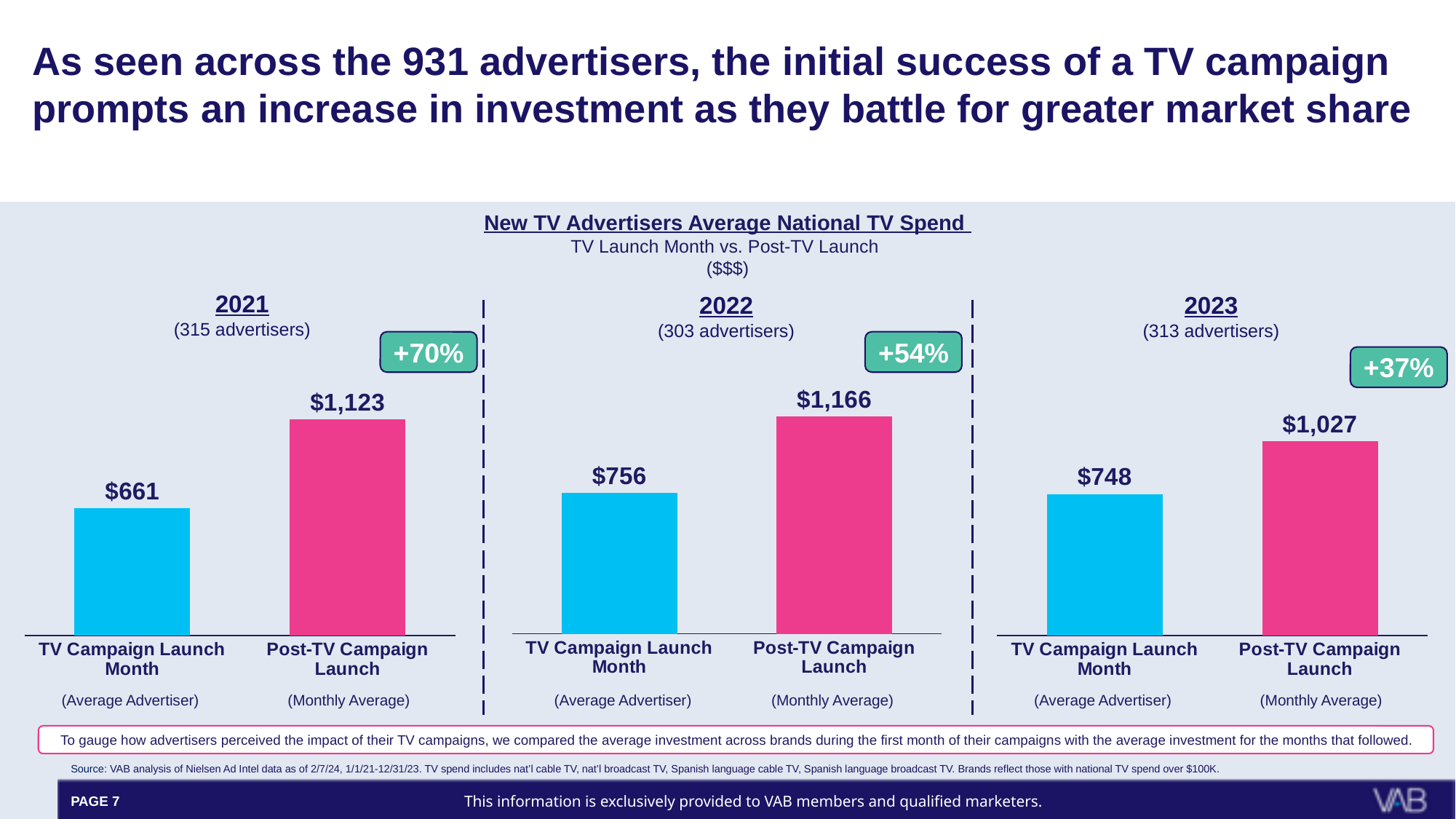
In the 2022 chart, what is the difference between the Post-TV Campaign Launch value and the TV Campaign Launch Month value? $410 How many bars are shown in the 2022 chart? 2 In the 2021 chart, what is the value for TV Campaign Launch Month? $661 In the 2022 chart, what is the value for Post-TV Campaign Launch? $1,166 What type of chart is used to show the 2023 data? Bar chart Across the three charts, which year has the lowest TV Campaign Launch Month value? 2021 In the 2021 chart, which bar is higher, TV Campaign Launch Month or Post-TV Campaign Launch? Post-TV Campaign Launch What percentage increase is shown in the callout above the 2023 chart? +37% In the 2023 chart, what is the difference between the Post-TV Campaign Launch value and the TV Campaign Launch Month value? $279 In the 2021 chart, what is the value for Post-TV Campaign Launch? $1,123 Across the three charts, which year has the highest Post-TV Campaign Launch value? 2022 In the 2023 chart, what is the value for TV Campaign Launch Month? $748